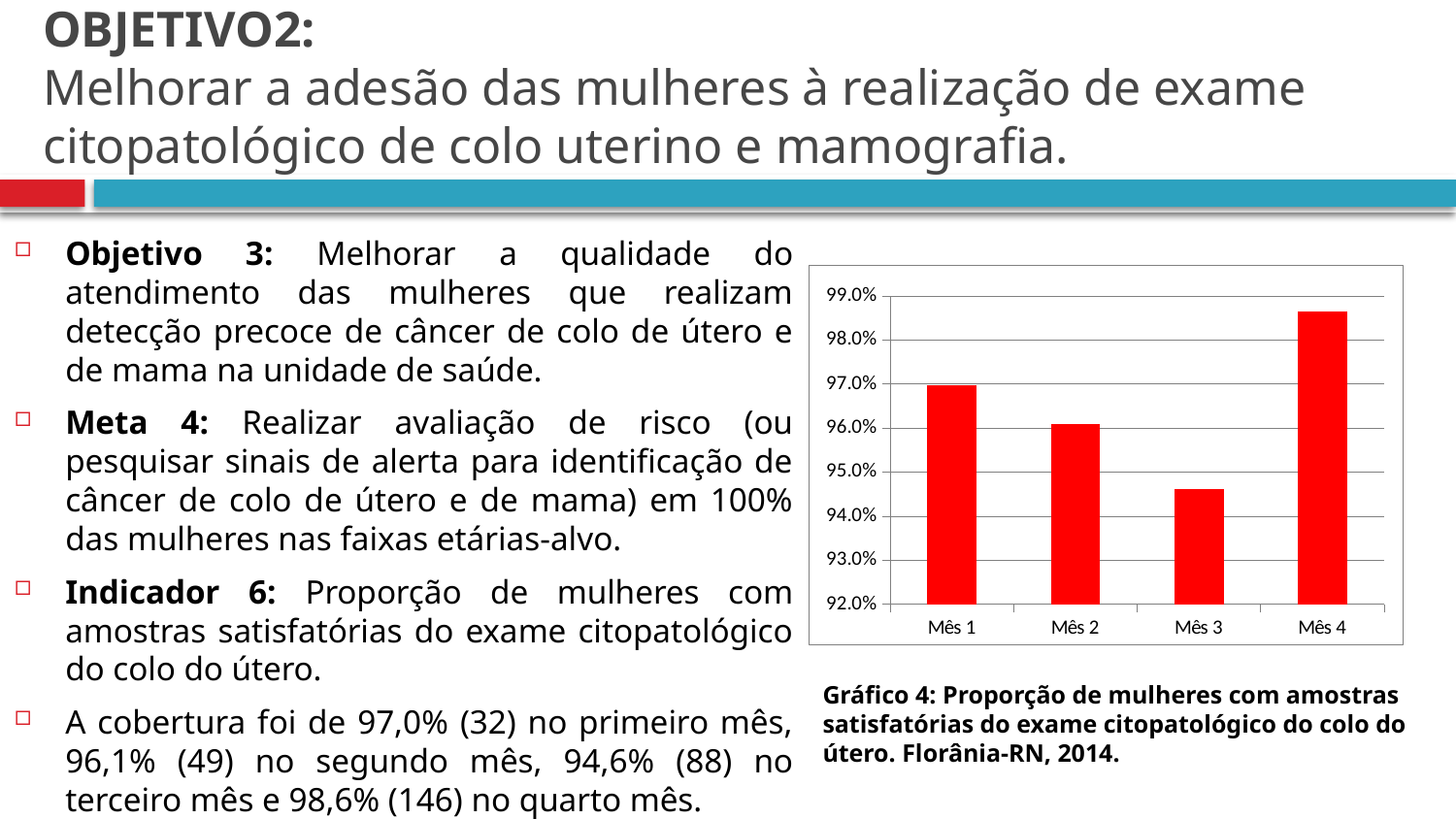
Which is larger, the value for Mês 1 or the value for Mês 2? Mês 1 Which is larger, the value for Mês 2 or the value for Mês 3? Mês 2 What kind of chart is shown on the slide? bar chart What is the lowest value shown on the chart's vertical axis? 92.0% Is the value for Mês 3 greater or less than 95.0%? less How many months (categories) are plotted in the chart? 4 What is the value for Mês 1 in the chart? 97.0% Which month has the highest bar in the chart? Mês 4 What colour are the bars in the chart? red Is the value for Mês 2 greater or less than 96.0%? greater Which month has the lowest bar in the chart? Mês 3 Is the value for Mês 4 greater or less than 98.0%? greater